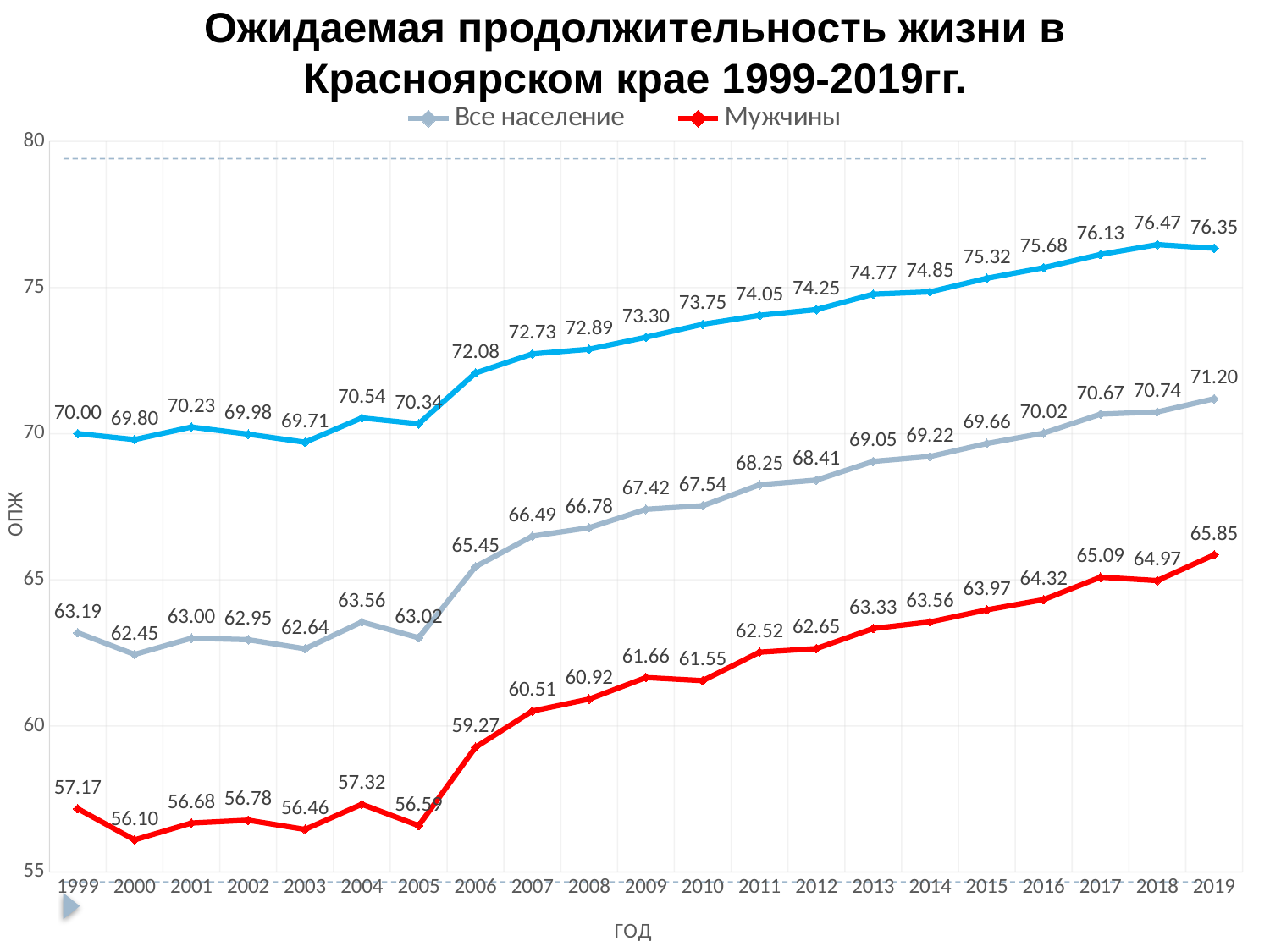
What is the value for Мужчины in 2006? 59.27 In which year is the value for Все население highest? 2019 How many years are plotted on the x axis? 21 What is the value for Все население in 1999? 63.19 Do the values for Мужчины generally rise or fall from 1999 to 2019? rise What is the value for Все население in 2013? 69.05 What is the difference between the Все население values in 2019 and 1999? 8.01 What kind of chart is shown on the slide? line chart What is the difference between the Все население and Мужчины values in 2019? 5.35 Is the value for Мужчины in 2010 greater or less than 60? greater In which year is the value for Мужчины lowest? 2000 Which is larger: the Мужчины value in 2009 or in 2010? 2009